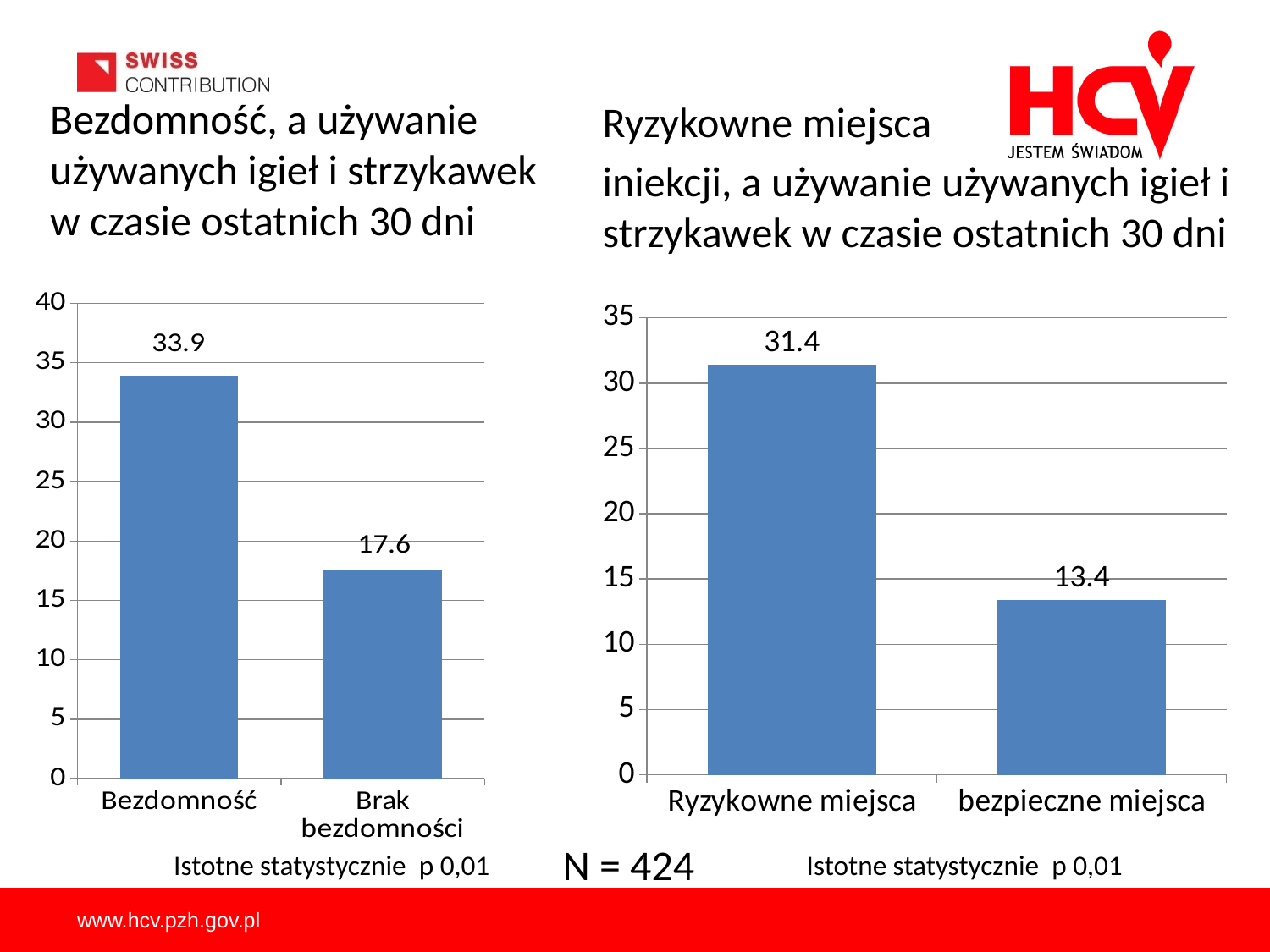
In the right chart (Ryzykowne miejsca iniekcji, a używanie używanych igieł i strzykawek w czasie ostatnich 30 dni), what is the value for Ryzykowne miejsca? 31.4 What is the sample size (N) stated on the slide? N = 424 In the left chart, which category has the highest value? Bezdomność How many categories are shown in the left chart? 2 In the right chart (Ryzykowne miejsca iniekcji, a używanie używanych igieł i strzykawek w czasie ostatnich 30 dni), what is the value for bezpieczne miejsca? 13.4 In the left chart (Bezdomność, a używanie używanych igieł i strzykawek w czasie ostatnich 30 dni), what is the value for Bezdomność? 33.9 In the right chart, what is the difference between the values for Ryzykowne miejsca and bezpieczne miejsca? 18 In the right chart, which category has the lowest value? bezpieczne miejsca In the right chart, which is larger: the value for Ryzykowne miejsca or for bezpieczne miejsca? Ryzykowne miejsca In the left chart (Bezdomność, a używanie używanych igieł i strzykawek w czasie ostatnich 30 dni), what is the value for Brak bezdomności? 17.6 What type of chart is the right chart? Bar chart In the left chart, what is the difference between the values for Bezdomność and Brak bezdomności? 16.3